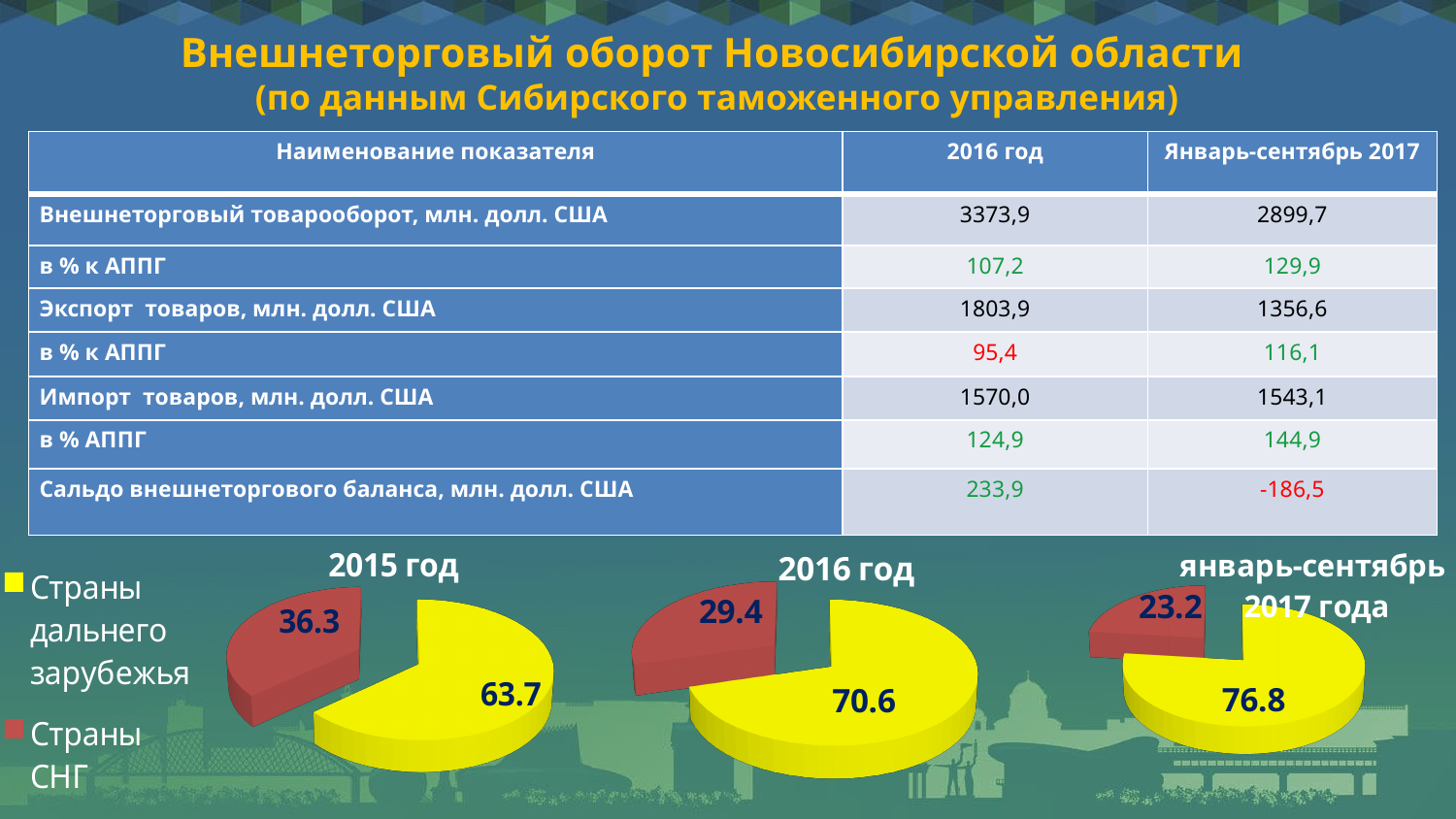
What kind of chart is used for the 2015, 2016 and январь-сентябрь 2017 data at the bottom of the slide? pie chart In the pie chart titled "январь-сентябрь 2017 года", what is the value for Страны дальнего зарубежья? 76.8 In the pie chart titled "2015 год", what is the difference between the Страны дальнего зарубежья slice and the Страны СНГ slice? 27.4 In the pie chart titled "2016 год", what is the value for Страны СНГ? 29.4 In the pie chart titled "2015 год", what is the value for Страны дальнего зарубежья? 63.7 In the pie chart titled "2016 год", which slice is larger: Страны дальнего зарубежья or Страны СНГ? Страны дальнего зарубежья Across the three pie charts, does the share of Страны СНГ rise or fall from 2015 to январь-сентябрь 2017? fall Which colour represents Страны СНГ in the pie charts? red In the pie chart titled "январь-сентябрь 2017 года", what is the value for Страны СНГ? 23.2 How many slices does the pie chart titled "2016 год" have? 2 In the pie chart titled "2015 год", what is the value for Страны СНГ? 36.3 In the pie chart titled "2016 год", what is the value for Страны дальнего зарубежья? 70.6